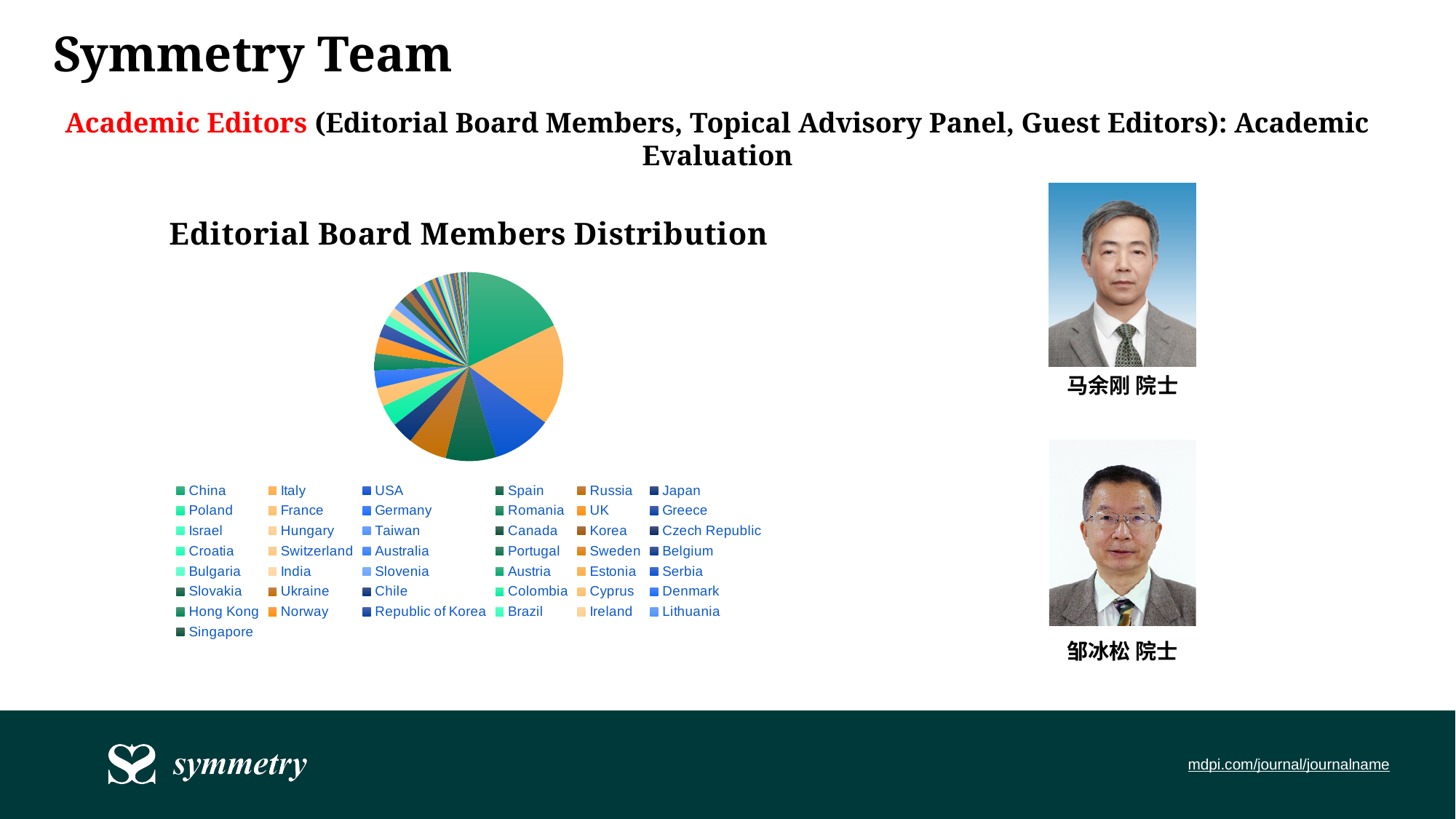
In the Editorial Board Members Distribution pie chart, which slice is larger, China or USA? China Which country is listed first in the legend of the Editorial Board Members Distribution pie chart? China How many countries or regions are listed in the legend of the Editorial Board Members Distribution pie chart? 43 Which country has the largest slice in the Editorial Board Members Distribution pie chart? China What kind of chart is shown under the title "Editorial Board Members Distribution"? pie chart In the Editorial Board Members Distribution pie chart, which slice is larger, Italy or Spain? Italy In the Editorial Board Members Distribution pie chart, which slice is larger, USA or Germany? USA What is the title of the pie chart on the slide? Editorial Board Members Distribution